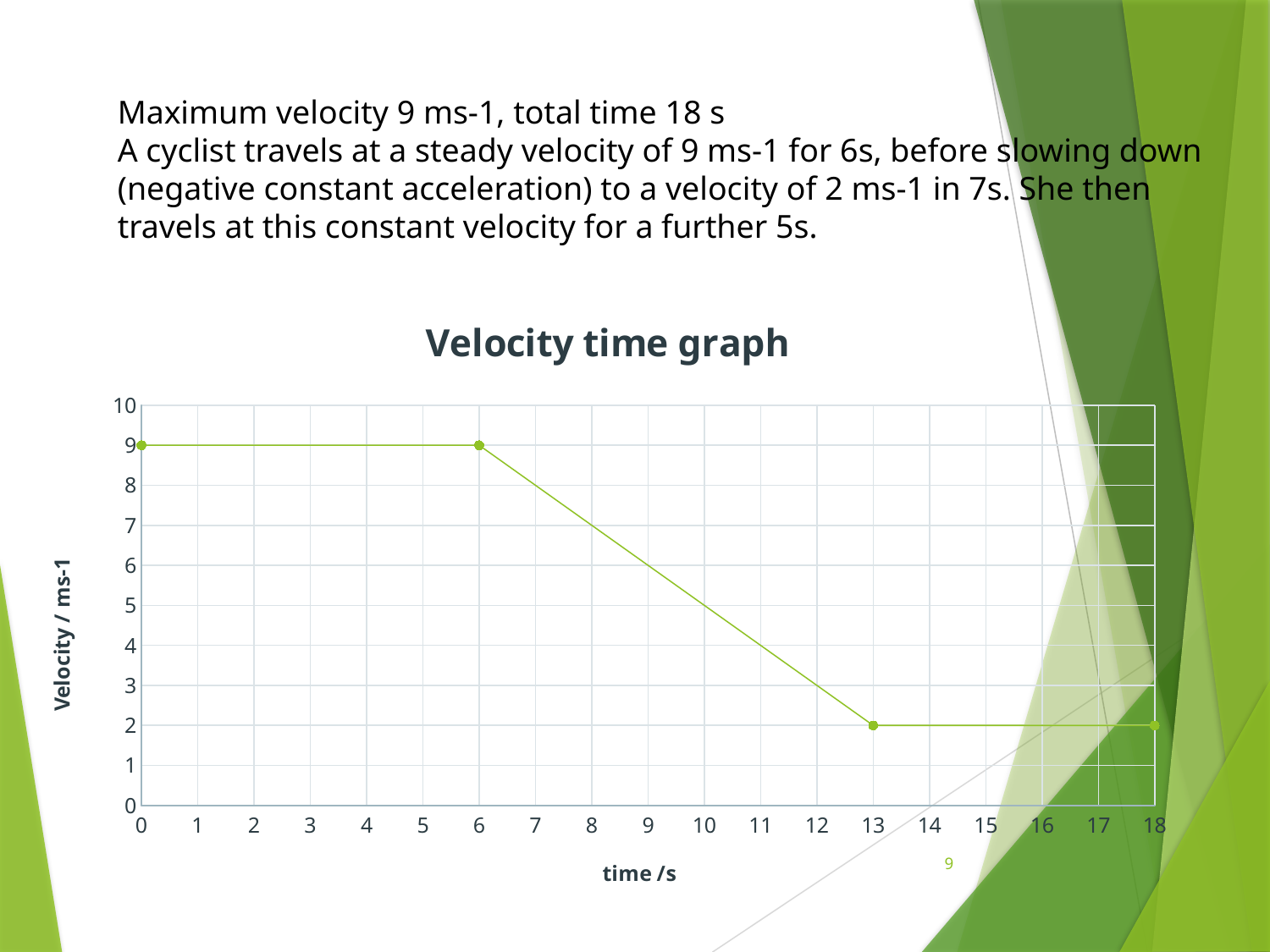
What is the highest velocity plotted on the chart? 9 What is the velocity at time 0 s? 9 What is the difference between the velocity at 6 s and the velocity at 13 s? 7 Between 6 s and 13 s, does the velocity rise or fall? fall What type of chart is shown on the slide? line chart How many data points are marked on the line? 4 What is the velocity at time 13 s? 2 What is the label of the vertical axis? Velocity / ms-1 What is the lowest velocity plotted on the chart? 2 What is the velocity at time 18 s? 2 What is the velocity at time 6 s? 9 What is the title of the chart? Velocity time graph